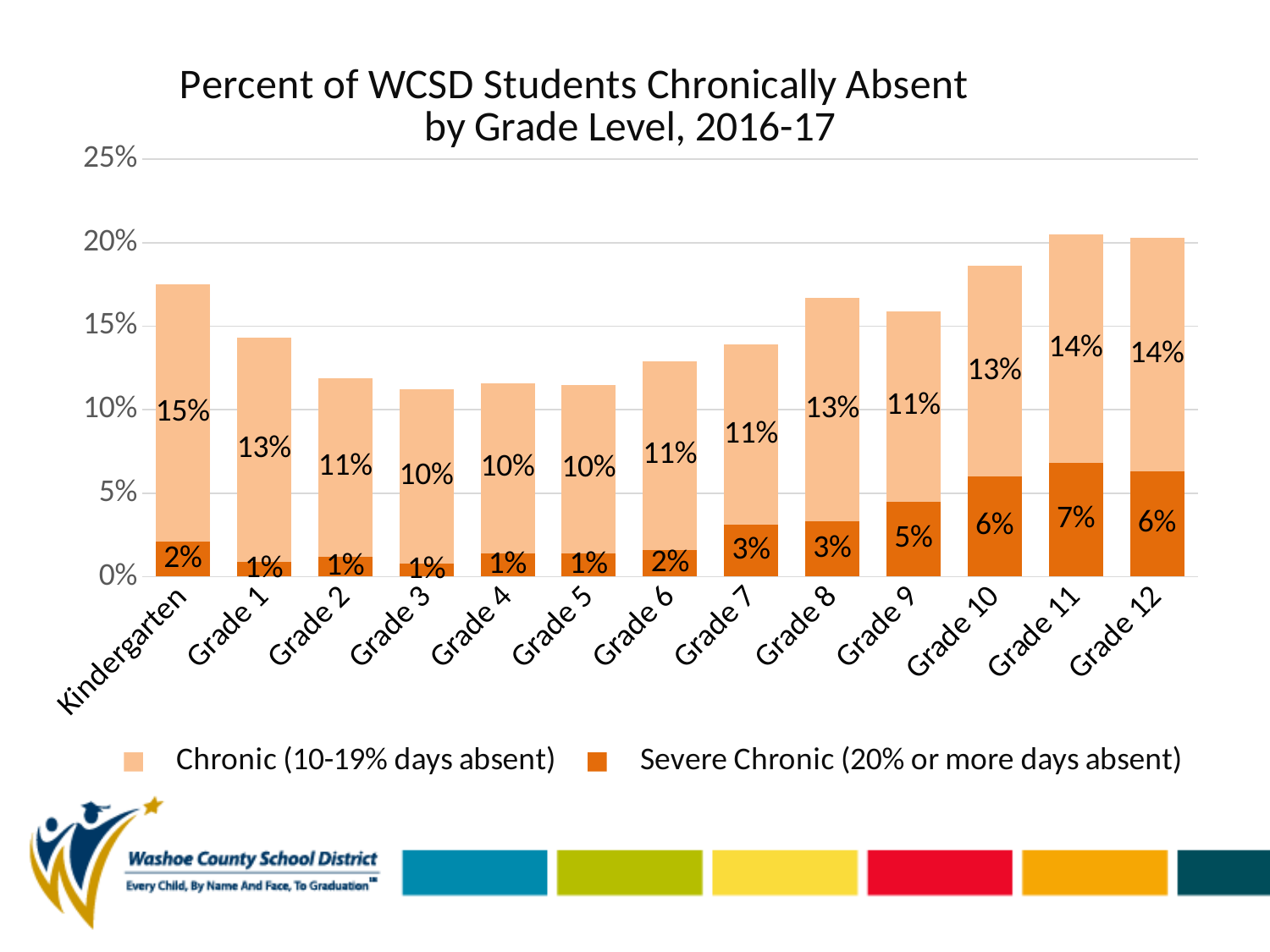
What is the difference between the Severe Chronic values for Grade 11 and Grade 7? 4% Which is larger, the Severe Chronic value for Grade 9 or for Grade 7? Grade 9 How many series does the legend list? 2 What type of chart is shown on the slide? Stacked bar chart What is the Chronic (10-19% days absent) value for Kindergarten? 15% Which grade level has the highest Severe Chronic value? Grade 11 How many grade levels are shown on the x axis? 13 What is the Severe Chronic (20% or more days absent) value for Grade 11? 7% What is the Severe Chronic value for Grade 9? 5% Is the total height of the Kindergarten bar greater or less than 15%? greater What is the Chronic value for Grade 8? 13% Which grade level has the highest Chronic (10-19% days absent) value? Kindergarten